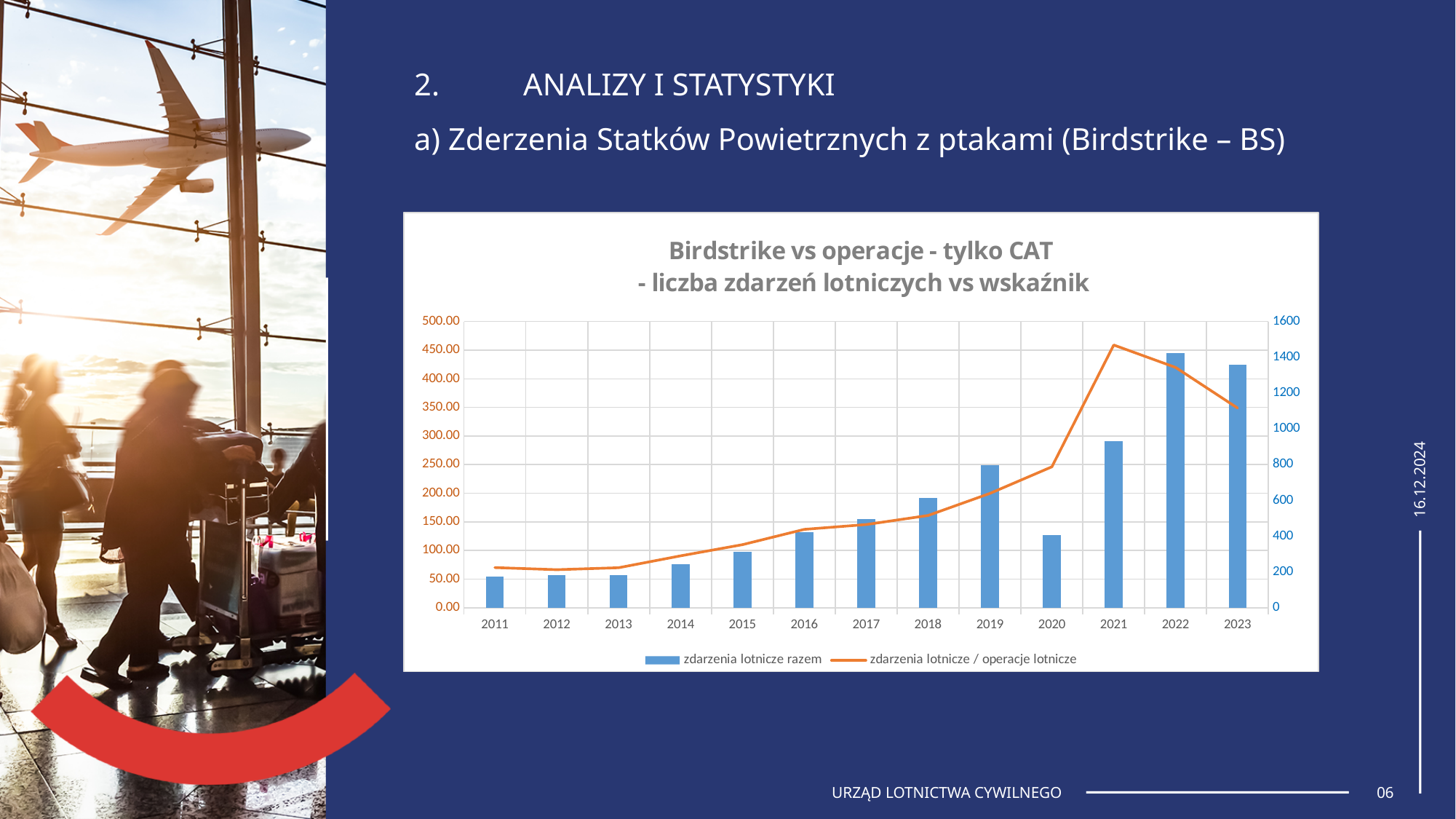
Is the bar for 2020 greater or less than 600 on the right axis? less In which year is the bar for 'zdarzenia lotnicze razem' the highest? 2022 What kind of chart is shown on the slide? Combined bar and line chart How many series does the legend list? 2 Do the bars generally rise or fall from 2011 to 2019? rise How many years are shown on the x axis? 13 What is the title of the chart? Birdstrike vs operacje - tylko CAT - liczba zdarzeń lotniczych vs wskaźnik Is the line value for 2021 greater or less than 400.00 on the left axis? greater Is the line value for 2011 greater or less than 100.00 on the left axis? less Which year has the taller bar, 2019 or 2020? 2019 In which year does the line 'zdarzenia lotnicze / operacje lotnicze' reach its highest point? 2021